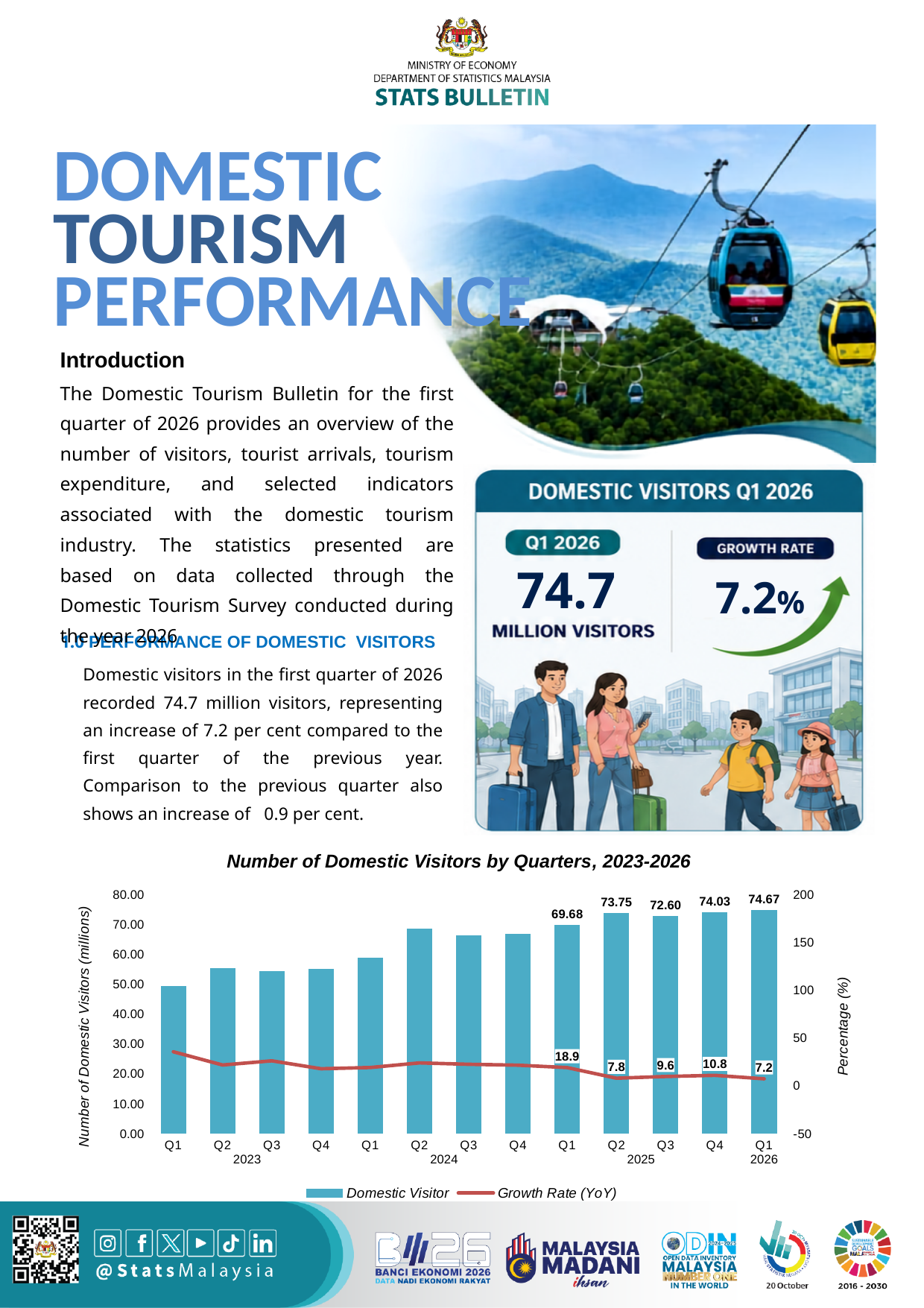
Which is larger, the number of domestic visitors in Q2 2025 or Q3 2025? Q2 2025 What is the number of domestic visitors (millions) for Q1 2026? 74.67 How many quarters are plotted on the chart? 13 What is the difference in domestic visitors (millions) between Q1 2026 and Q1 2025? 4.99 How many series does the legend list? 2 What is the title of the chart? Number of Domestic Visitors by Quarters, 2023-2026 What is the growth rate (YoY) for Q4 2025? 10.8 What is the growth rate (YoY) for Q1 2025? 18.9 Which quarter has the highest number of domestic visitors? Q1 2026 Which quarter has the lowest number of domestic visitors? Q1 2023 What is the number of domestic visitors (millions) for Q2 2025? 73.75